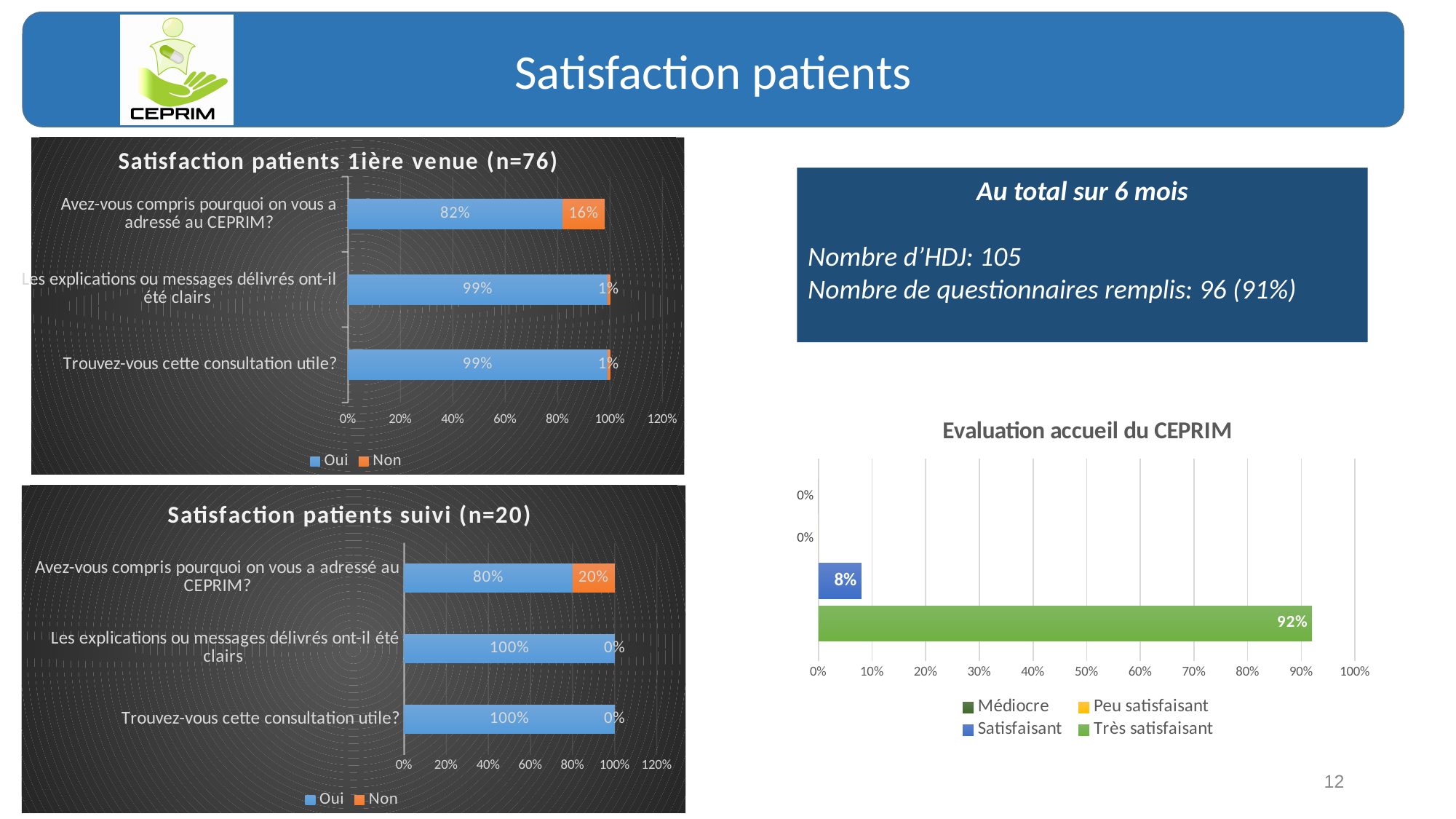
In the 'Evaluation accueil du CEPRIM' chart, which category has the highest value? Très satisfaisant In the 'Satisfaction patients suivi (n=20)' chart, what is the 'Oui' value for 'Les explications ou messages délivrés ont-il été clairs'? 100% In the 'Satisfaction patients 1ière venue (n=76)' chart, what percentage answered 'Non' to 'Avez-vous compris pourquoi on vous a adressé au CEPRIM?' 16% In the 'Satisfaction patients suivi (n=20)' chart, what is the difference between the 'Oui' and 'Non' values for 'Avez-vous compris pourquoi on vous a adressé au CEPRIM?' 60% In the 'Satisfaction patients 1ière venue (n=76)' chart, which question has the lowest 'Oui' percentage? Avez-vous compris pourquoi on vous a adressé au CEPRIM? In the 'Evaluation accueil du CEPRIM' chart, what is the value for 'Satisfaisant'? 8% In the 'Satisfaction patients 1ière venue (n=76)' chart, what is the 'Oui' value for 'Trouvez-vous cette consultation utile?' 99% What kind of chart is 'Evaluation accueil du CEPRIM'? Bar chart How many series does the legend of the 'Satisfaction patients suivi (n=20)' chart list? 2 In the 'Evaluation accueil du CEPRIM' chart, what is the value for 'Très satisfaisant'? 92% In the 'Satisfaction patients suivi (n=20)' chart, what percentage answered 'Non' to 'Avez-vous compris pourquoi on vous a adressé au CEPRIM?' 20% In the 'Satisfaction patients 1ière venue (n=76)' chart, what percentage answered 'Oui' to 'Avez-vous compris pourquoi on vous a adressé au CEPRIM?' 82%